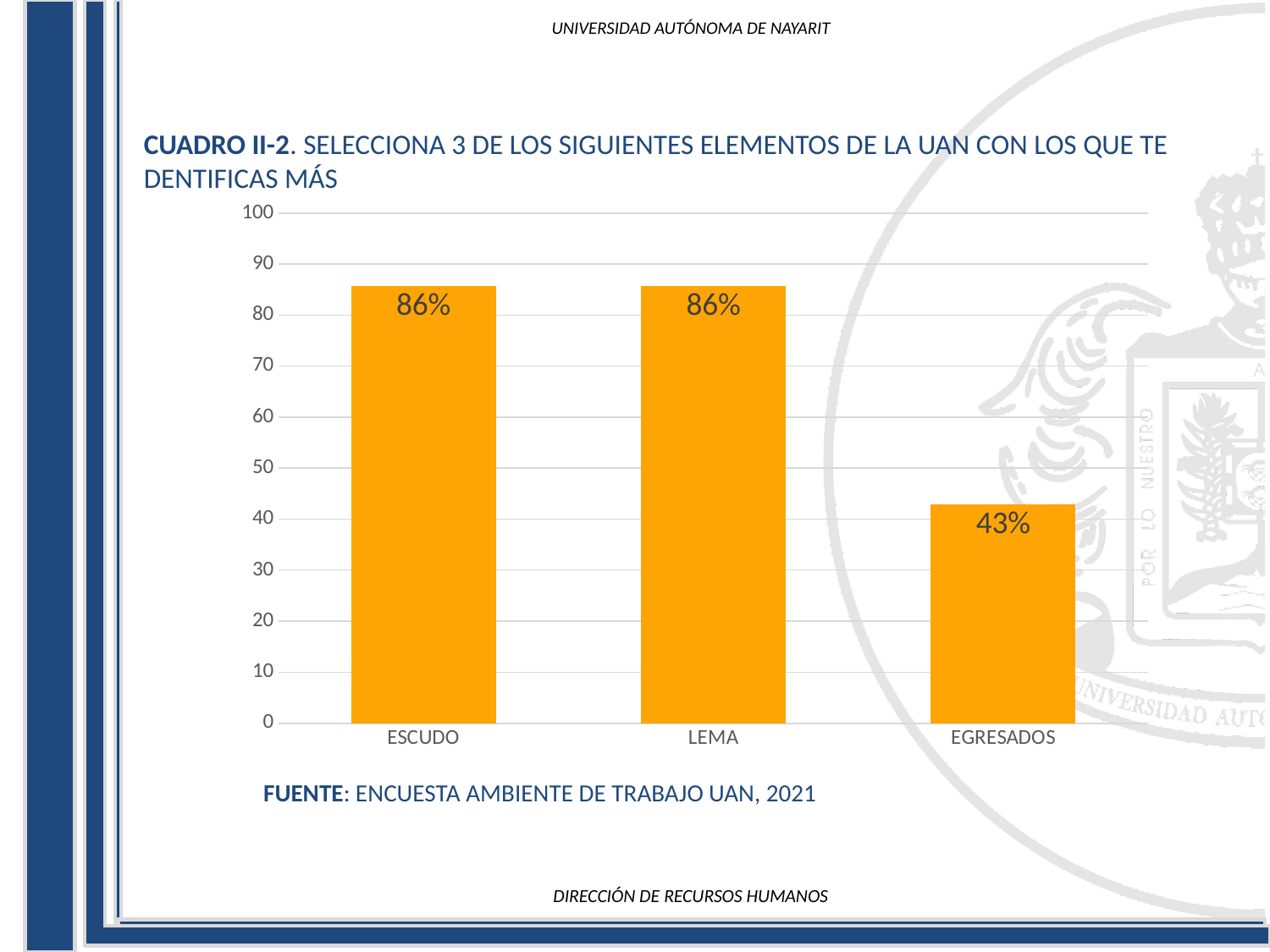
What source is cited below the chart? ENCUESTA AMBIENTE DE TRABAJO UAN, 2021 What is the value for ESCUDO? 86% What kind of chart is shown on the slide? bar chart Which is larger, the value for LEMA or the value for EGRESADOS? LEMA Is the value for ESCUDO greater or less than 80? greater Is the value for EGRESADOS greater or less than 50? less What is the difference between the values for ESCUDO and EGRESADOS? 43% What is the value for LEMA? 86% Which category has the lowest value? EGRESADOS What is the value for EGRESADOS? 43% How many categories are shown on the x axis? 3 What is the difference between the values for LEMA and EGRESADOS? 43%